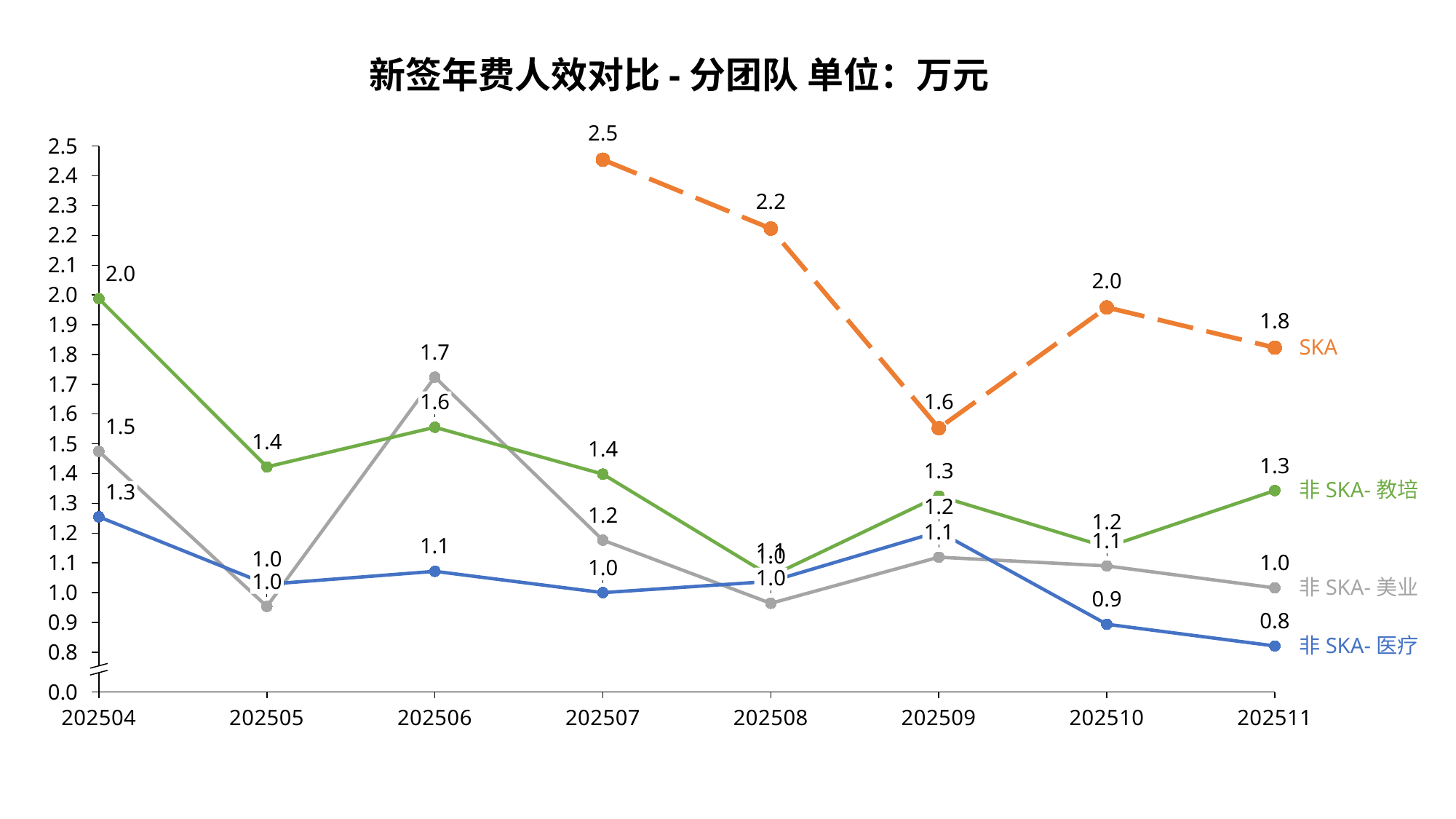
What is the title of the chart? 新签年费人效对比 - 分团队 单位：万元 At 202510, which is larger: SKA or 非SKA-教培? SKA What is the difference between the SKA value at 202507 and at 202511? 0.7 How many series are labelled on the chart? 4 How many time periods are shown on the x axis? 8 What kind of chart is shown on the slide? line chart In which period does SKA reach its highest value? 202507 What is the value for 非SKA-教培 at 202504? 2.0 What is the value for 非SKA-医疗 at 202510? 0.9 What is the value for 非SKA-美业 at 202506? 1.7 What is the value for SKA at 202507? 2.5 In which period does 非SKA-医疗 reach its lowest value? 202511